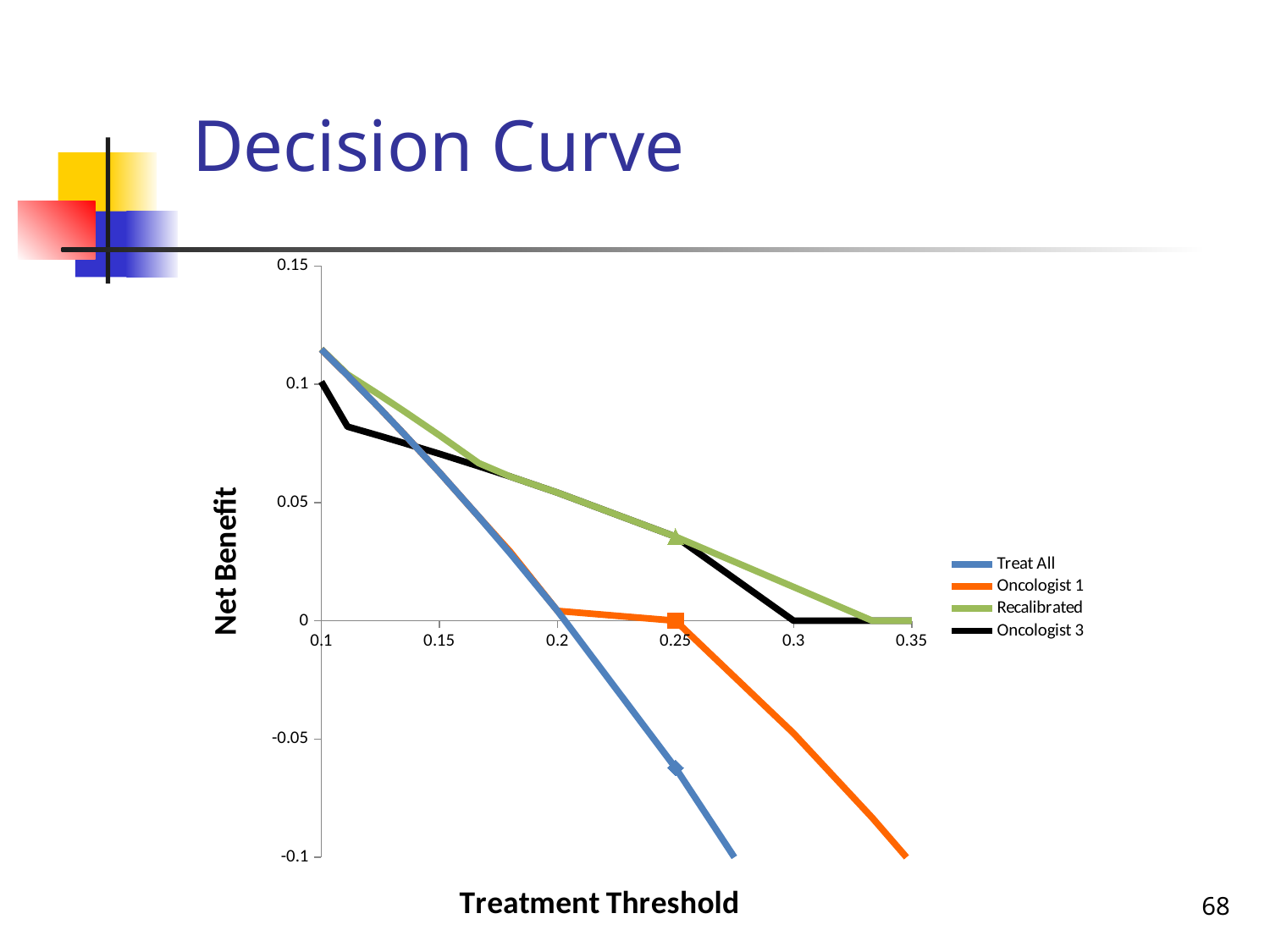
How many series does the legend list? 4 What kind of chart is shown on the slide? line chart Is the Net Benefit for Recalibrated at a Treatment Threshold of 0.25 greater or less than 0.05? less Which series has the lowest Net Benefit at a Treatment Threshold of 0.3? Treat All What is the Net Benefit for Oncologist 3 at a Treatment Threshold of 0.3? 0 What is the Net Benefit for Oncologist 3 at a Treatment Threshold of 0.1? 0.1 Does the Net Benefit for Treat All rise or fall as the Treatment Threshold increases? fall Is the Net Benefit for Oncologist 1 at a Treatment Threshold of 0.3 greater or less than 0? less What is the title of the chart? Decision Curve Is the Net Benefit for Treat All at a Treatment Threshold of 0.15 greater or less than 0.05? greater What is the label of the x axis? Treatment Threshold